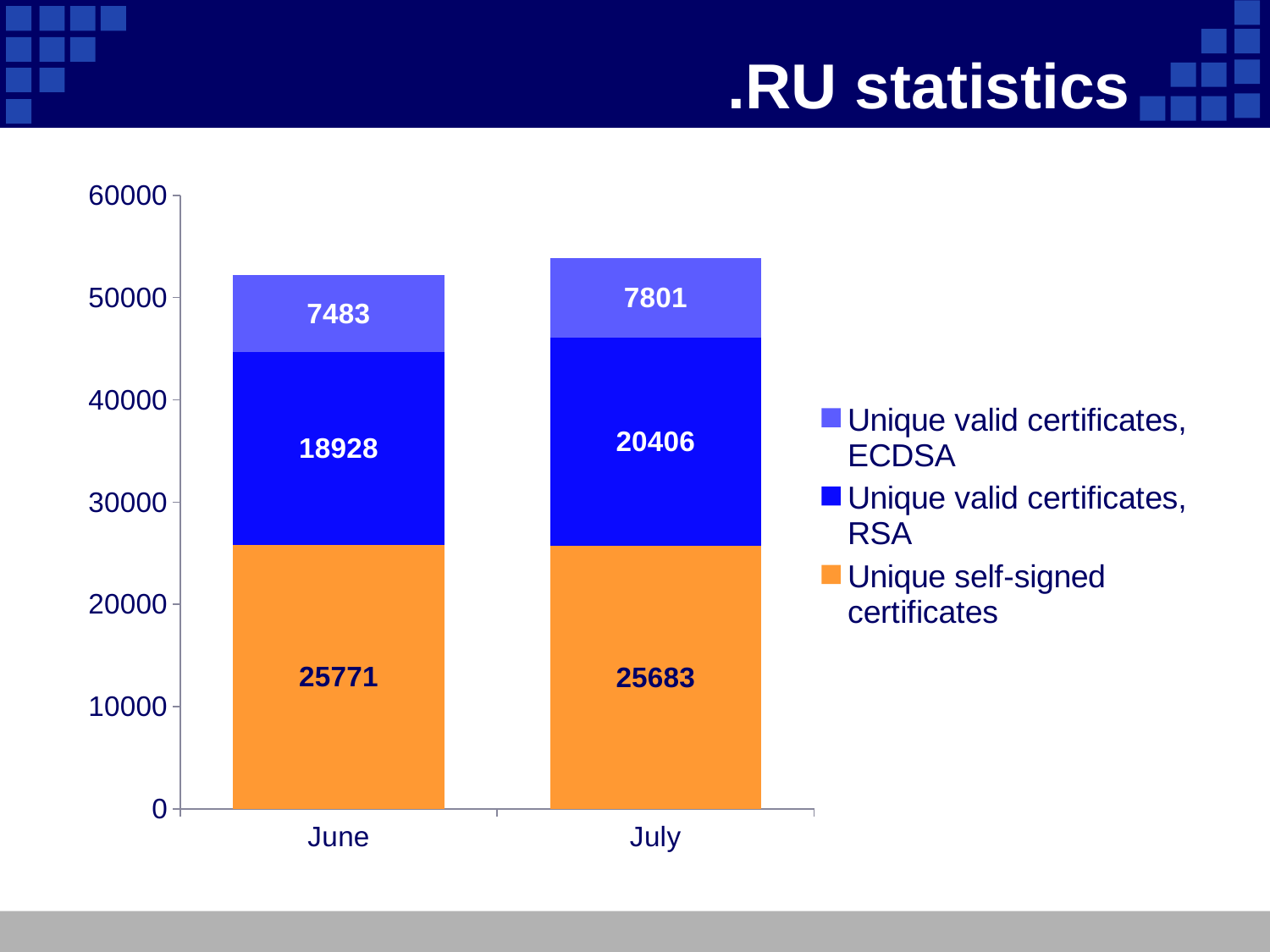
What is the value for Unique valid certificates, RSA in June? 18928 What is the value for Unique self-signed certificates in July? 25683 What is the difference between the Unique valid certificates, RSA values for July and June? 1478 Which series has the largest value in June? Unique self-signed certificates Which is larger: Unique valid certificates, ECDSA in June or in July? July What is the total of the stacked bar for June? 52182 What is the total of the stacked bar for July? 53890 What is the title of the slide containing the chart? .RU statistics What is the value for Unique valid certificates, ECDSA in July? 7801 What kind of chart is shown on the slide? Stacked bar chart How many categories are shown on the x axis? 2 How many series does the legend list? 3